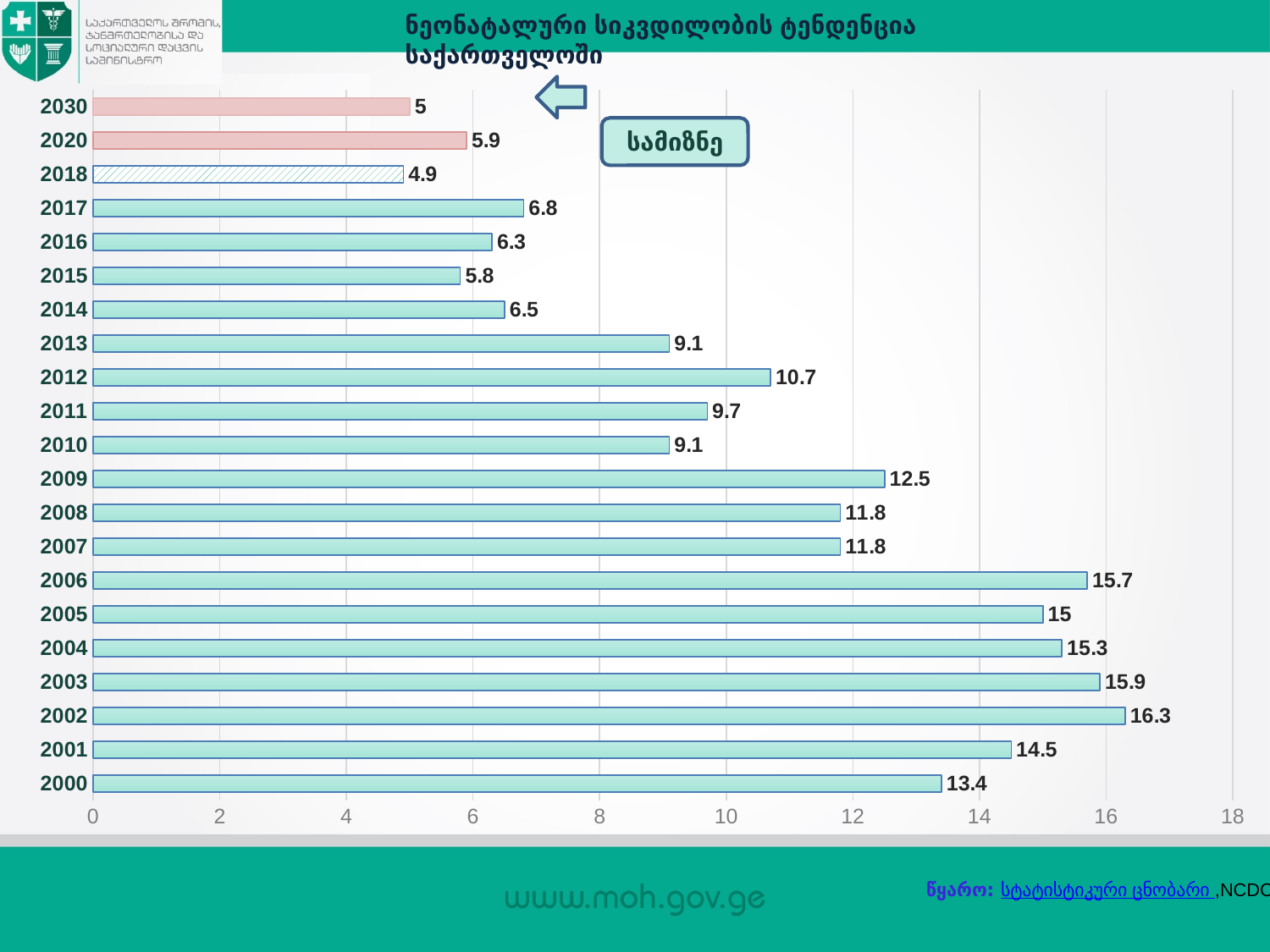
What is the value shown for 2012? 10.7 Is the value for 2006 greater or less than 14? greater What is the value shown for 2018? 4.9 How many years (bars) are shown in the chart? 21 What is the difference between the values for 2000 and 2017? 6.6 What kind of chart is shown on the slide? bar chart Which year has the highest value? 2002 What is the value shown for 2002? 16.3 Which year has the lowest value? 2018 Which is larger, the value for 2009 or the value for 2013? 2009 What is the value shown for 2030? 5 Do the values generally rise or fall from 2000 to 2018? fall